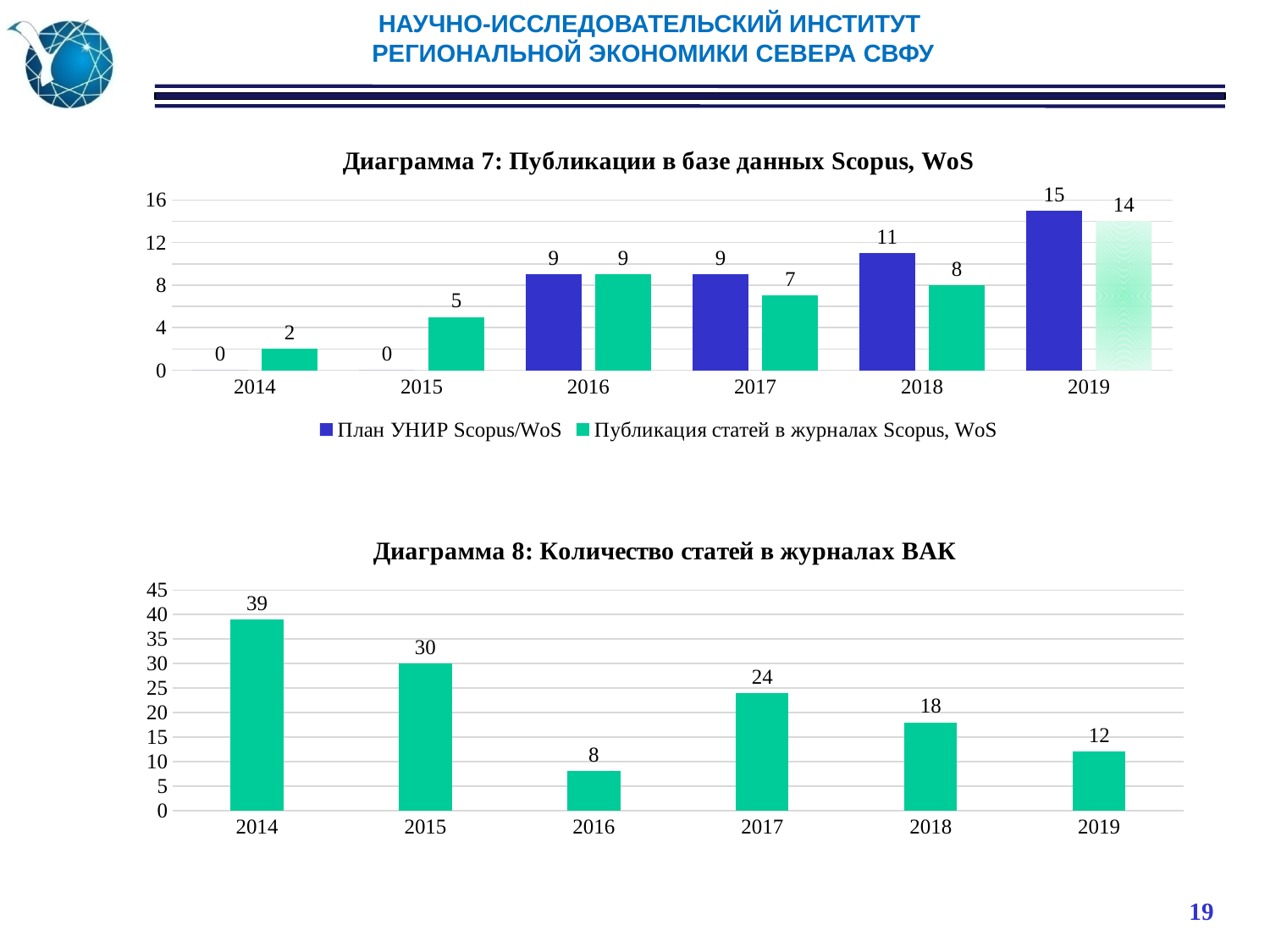
In the chart 'Диаграмма 7: Публикации в базе данных Scopus, WoS', what is the value of 'Публикация статей в журналах Scopus, WoS' for 2015? 5 In the chart 'Диаграмма 7: Публикации в базе данных Scopus, WoS', which year has the highest value for 'Публикация статей в журналах Scopus, WoS'? 2019 How many years are shown on the x axis of the chart 'Диаграмма 8: Количество статей в журналах ВАК'? 6 How many series does the legend of the chart 'Диаграмма 7: Публикации в базе данных Scopus, WoS' list? 2 In the chart 'Диаграмма 7: Публикации в базе данных Scopus, WoS', which is larger in 2017: 'План УНИР Scopus/WoS' or 'Публикация статей в журналах Scopus, WoS'? План УНИР Scopus/WoS What kind of chart is 'Диаграмма 8: Количество статей в журналах ВАК'? bar chart In the chart 'Диаграмма 7: Публикации в базе данных Scopus, WoS', what is the difference between 'План УНИР Scopus/WoS' and 'Публикация статей в журналах Scopus, WoS' in 2018? 3 In the chart 'Диаграмма 7: Публикации в базе данных Scopus, WoS', does the value of 'План УНИР Scopus/WoS' rise or fall from 2015 to 2019? rise In the chart 'Диаграмма 7: Публикации в базе данных Scopus, WoS', what is the value of 'План УНИР Scopus/WoS' for 2018? 11 In the chart 'Диаграмма 8: Количество статей в журналах ВАК', what is the value for 2017? 24 In the chart 'Диаграмма 8: Количество статей в журналах ВАК', which year has the lowest value? 2016 In the chart 'Диаграмма 8: Количество статей в журналах ВАК', what is the difference between the values for 2014 and 2015? 9